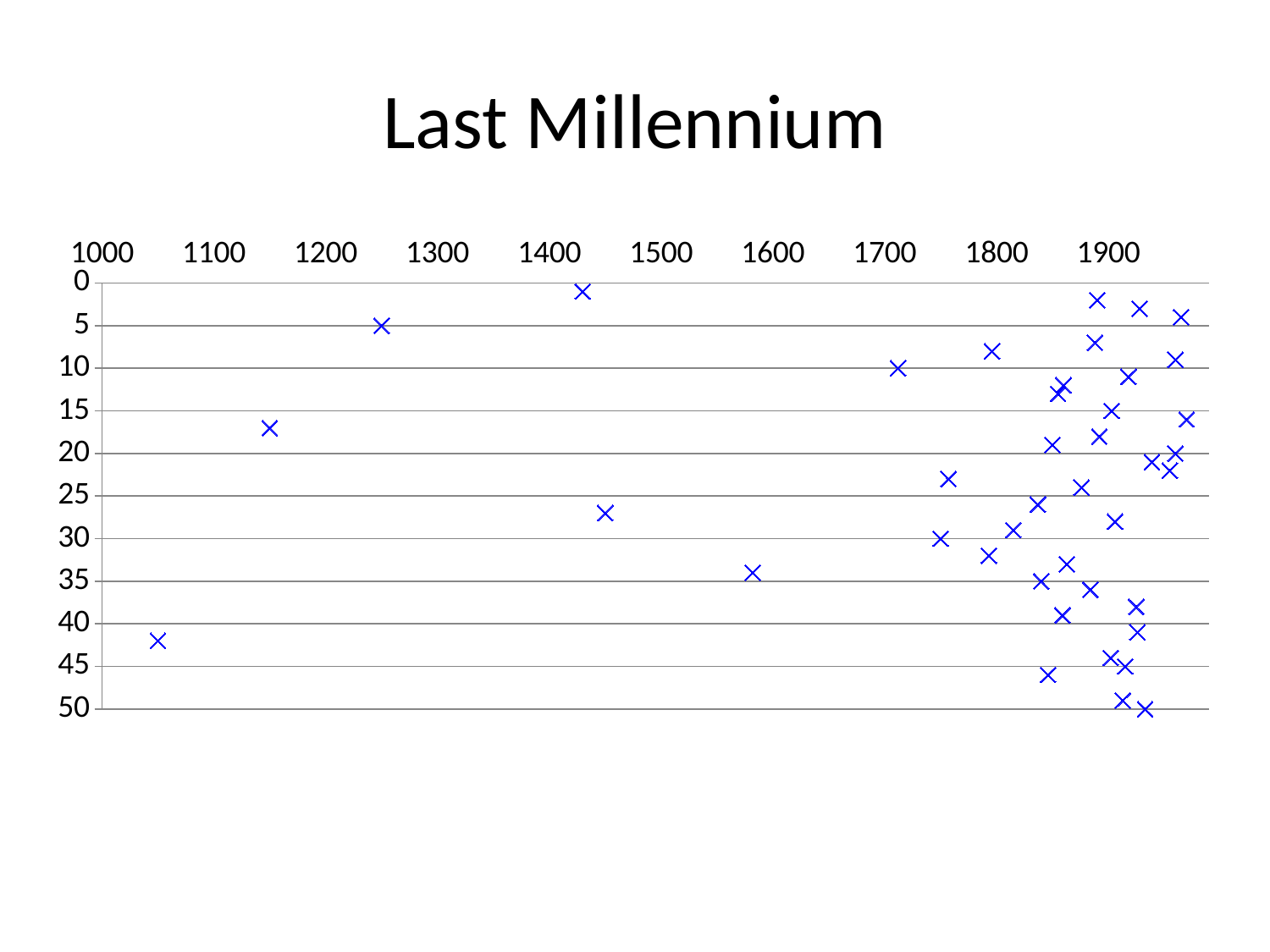
Is the y value of the point plotted near x=1450 (the lower of the two points near 1400-1450) greater or less than 25? greater What colour are the data markers in the chart? blue How many data points are plotted between the 1500 and 1700 ticks on the x axis? 1 Is the y value of the point plotted near x=1150 greater or less than 15? greater Which point has the smallest x value (earliest year) in the chart: the one near x=1050 or the one near x=1250? the point near x=1050 How many data points are plotted to the left of the 1500 tick on the x axis? 5 Which has the larger y value: the point plotted near x=1150 or the point plotted near x=1250? the point near x=1150 Is the y value of the point plotted near x=1050 greater or less than 40? greater What is the title of the chart? Last Millennium What kind of chart is shown on the slide? scatter chart